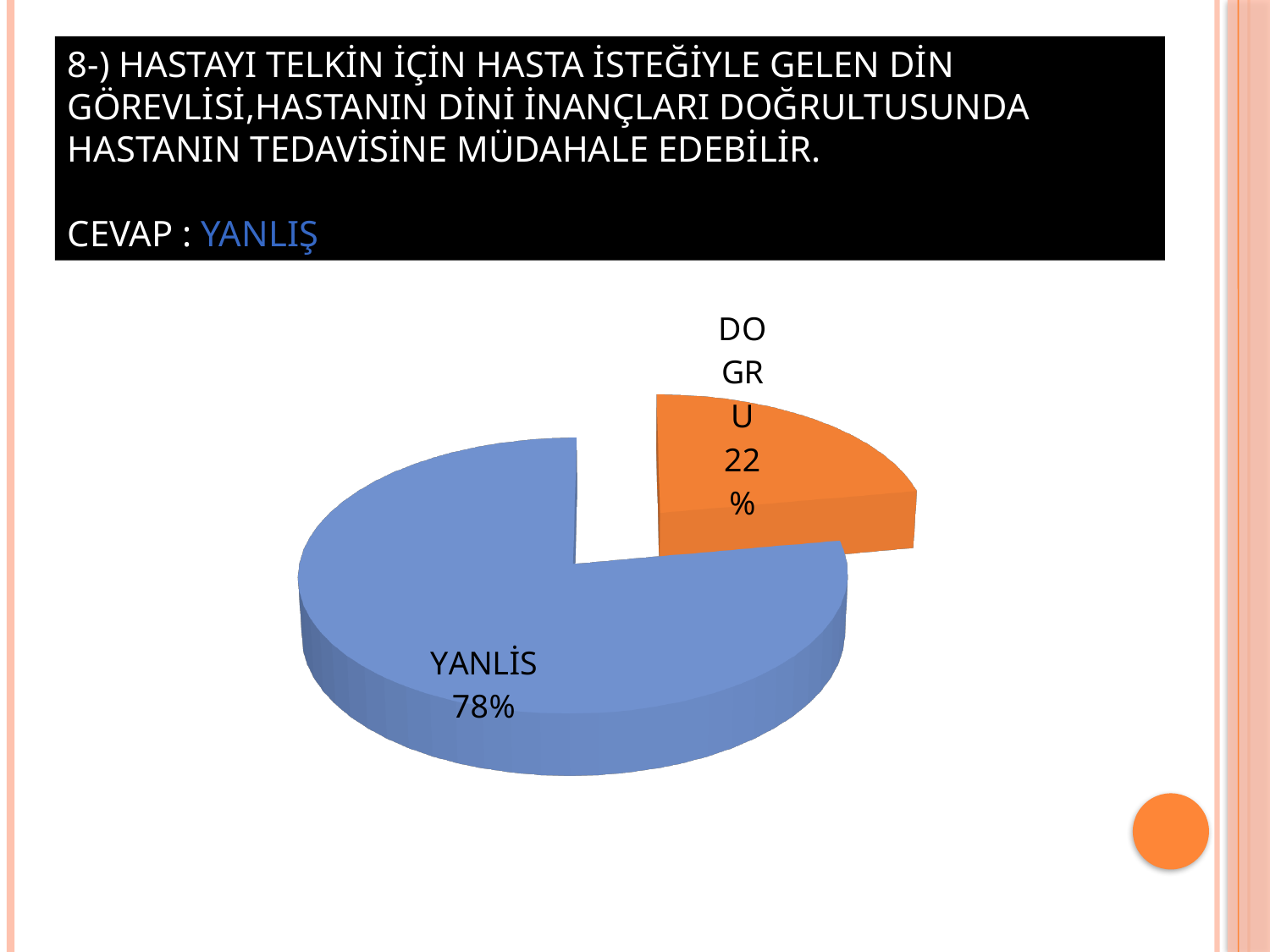
What percentage is shown for the DOGRU slice? 22% What colour is the DOGRU slice? orange Which slice of the pie chart is the smallest? DOGRU What colour is the YANLİS slice? blue Which slice is larger, YANLİS or DOGRU? YANLİS What share of the pie does the DOGRU slice represent? 22% What is the total of the two slice percentages shown on the pie chart? 100% What kind of chart is shown on the slide? pie chart How many slices does the pie chart have? 2 What is the difference in percentage points between the YANLİS and DOGRU slices? 56 What percentage is shown for the YANLİS slice? 78% Which slice of the pie chart is the largest? YANLİS